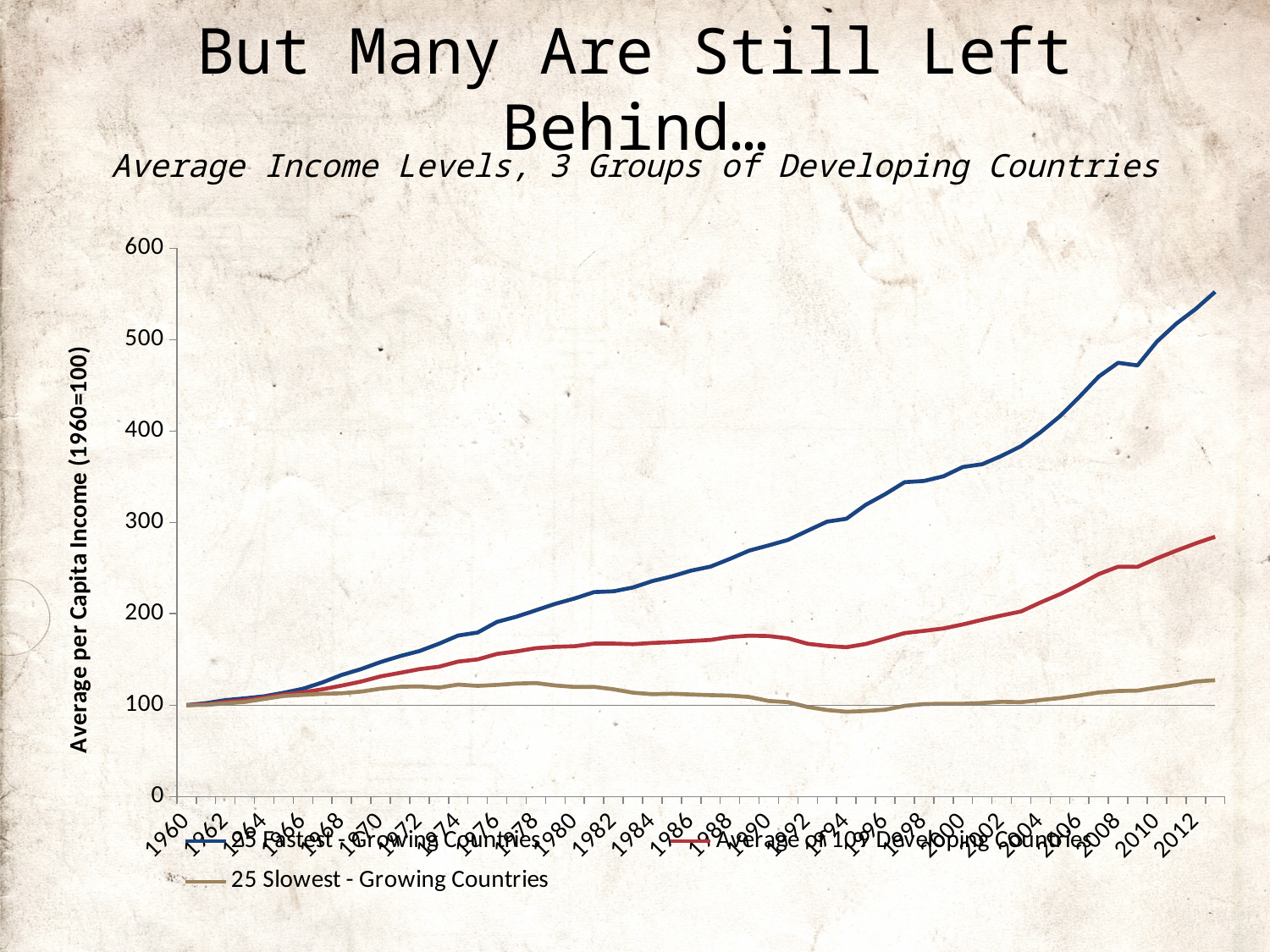
Is the value for Average of 109 Developing Countries in 2012 greater or less than 300? less What is the label on the vertical axis? Average per Capita Income (1960=100) Which series has the highest value in 2012? 25 Fastest - Growing Countries Is the value for 25 Fastest - Growing Countries in 2000 greater or less than 300? greater What kind of chart is shown on the slide? line chart What value do all three series have in 1960? 100 What is the title of the chart? Average Income Levels, 3 Groups of Developing Countries Which series has the lowest value in 2012? 25 Slowest - Growing Countries Is the value for 25 Fastest - Growing Countries in 2012 greater or less than 500? greater Does the 25 Fastest - Growing Countries series rise or fall from 1960 to 2012? rise How many series does the legend list? 3 In 2012, which is larger: the value for 25 Fastest - Growing Countries or the value for Average of 109 Developing Countries? 25 Fastest - Growing Countries